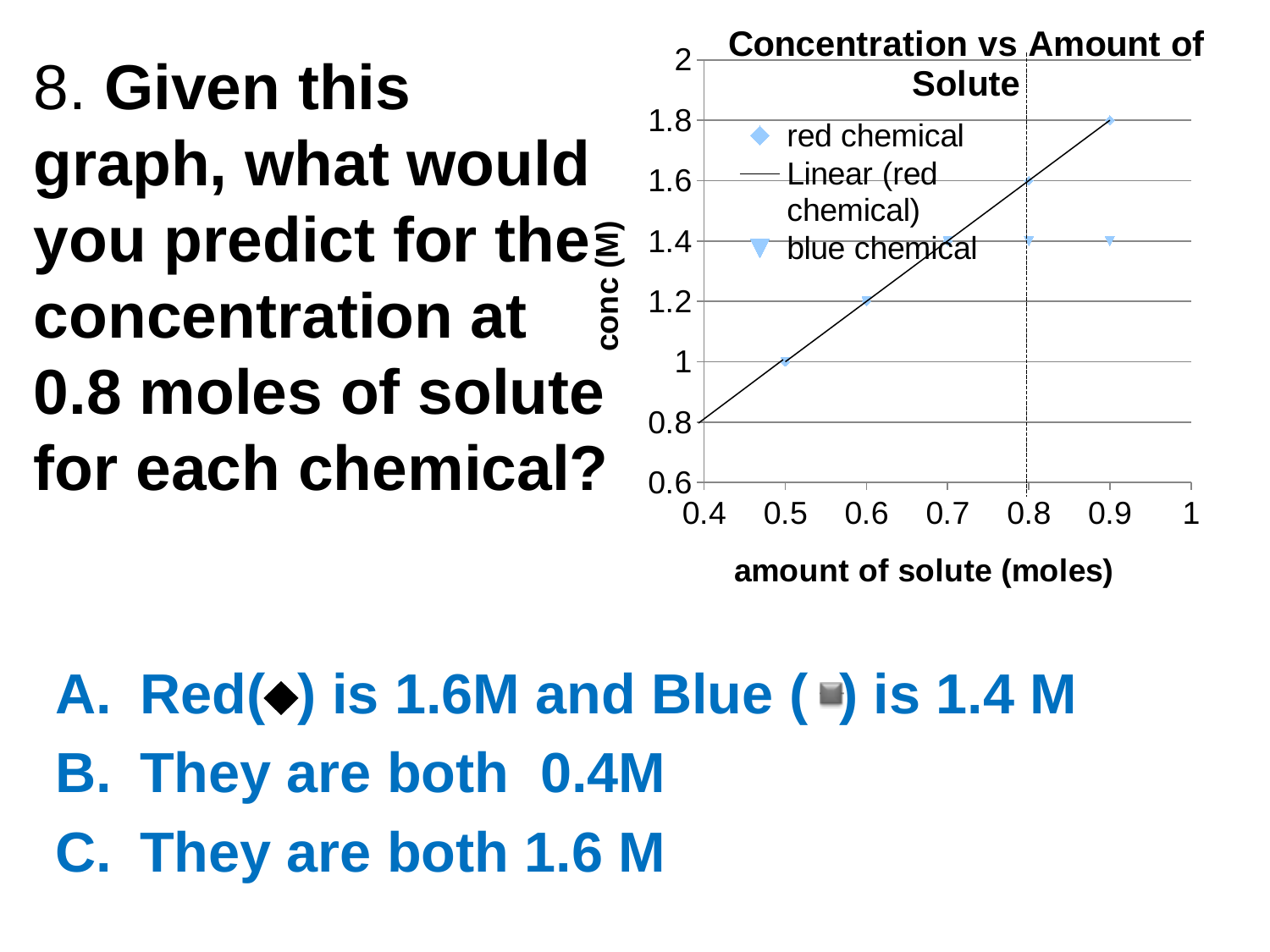
What is the concentration of the red chemical at 0.5 moles of solute? 1 Do the red chemical concentrations rise or fall as the amount of solute increases? rise What is the label of the x axis? amount of solute (moles) What is the difference between the red chemical and blue chemical concentrations at 0.9 moles of solute? 0.4 What is the title of the chart? Concentration vs Amount of Solute What kind of chart is shown on the slide? scatter chart How many entries does the chart legend list? 3 Is the concentration of the red chemical at 0.5 moles greater or less than 1.2? less At which amount of solute does the red chemical reach its highest concentration? 0.9 What is the concentration of the red chemical at 0.9 moles of solute? 1.8 What is the concentration of the blue chemical at 0.9 moles of solute? 1.4 At 0.9 moles of solute, which chemical has the higher concentration, red or blue? red chemical